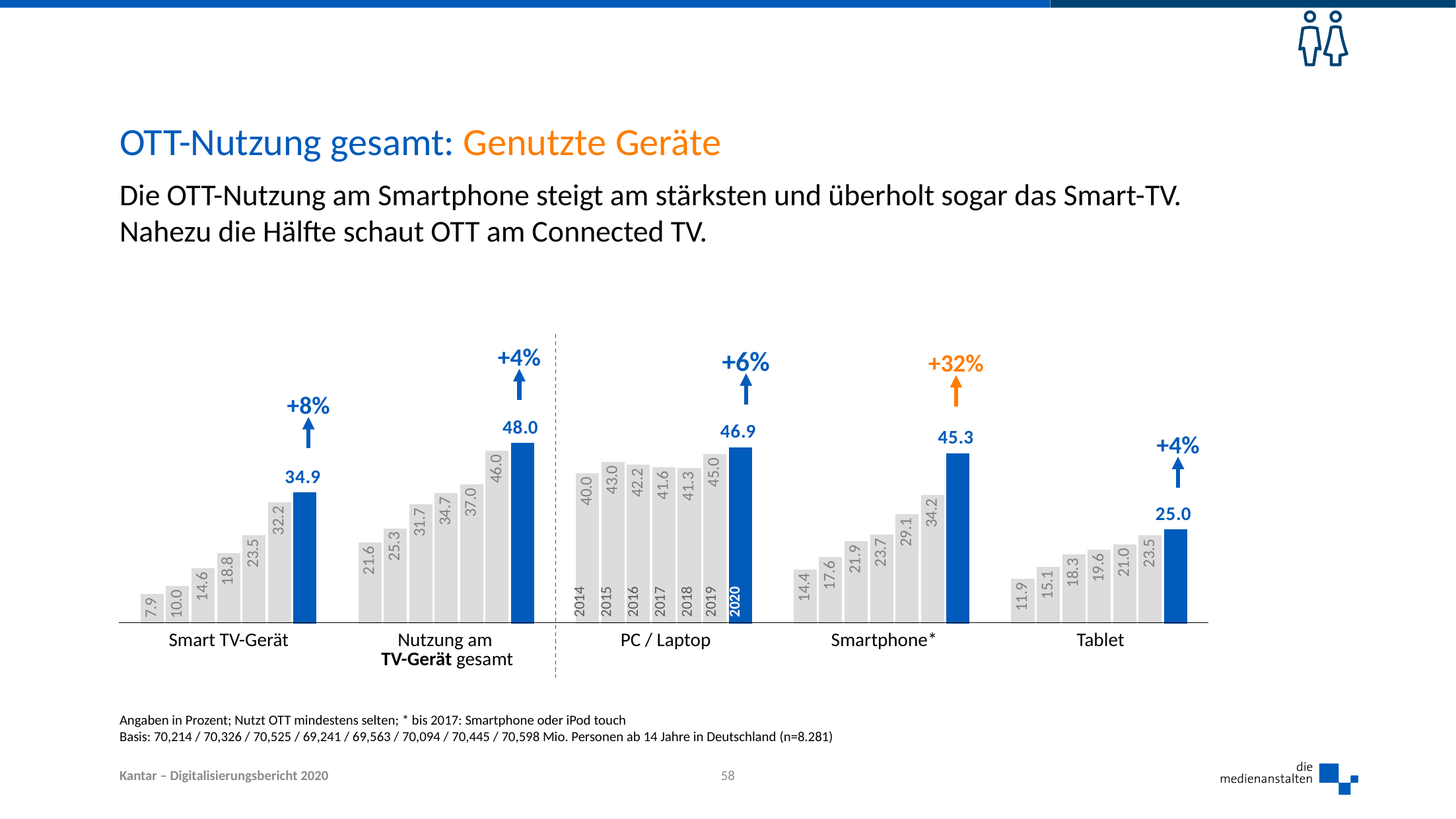
How many device groups are shown on the x axis? 5 What kind of chart is shown on the slide? Bar chart What is the 2014 value for PC / Laptop? 40.0 Which is larger in 2020: Smartphone* or Smart TV-Gerät? Smartphone* What is the 2020 value for Smartphone*? 45.3 Which device group has the lowest 2020 value? Tablet Which device group has the highest 2020 value? Nutzung am TV-Gerät gesamt What percentage change is shown above the Smartphone* group? +32% What is the 2020 value for Nutzung am TV-Gerät gesamt? 48.0 What is the 2020 value for Tablet? 25.0 How many years (bars) are shown for each device group? 7 What is the difference between the 2020 and 2014 values for Smart TV-Gerät? 27.0